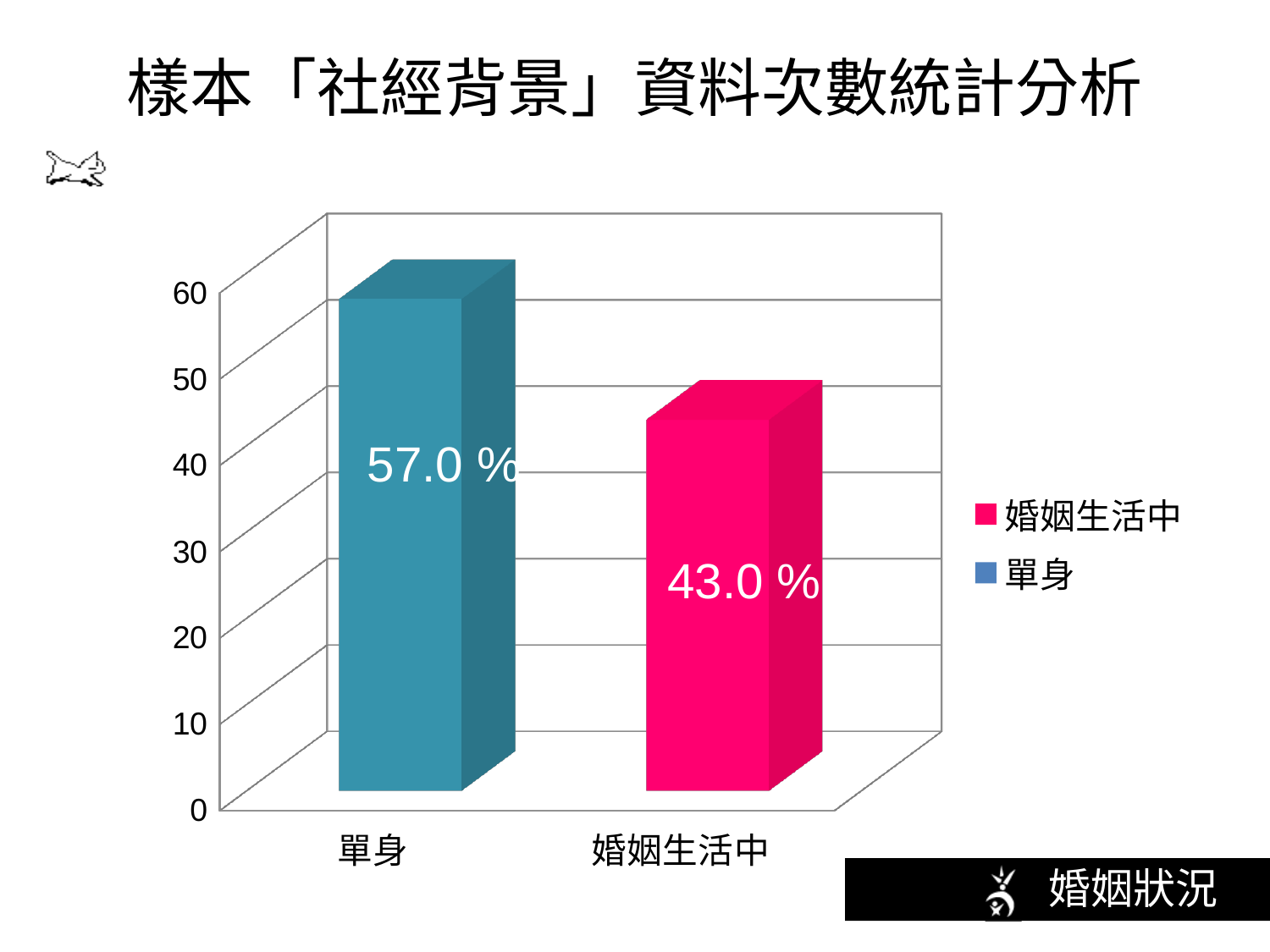
How many categories are shown on the x axis? 2 What kind of chart is shown on the slide? bar chart What is the value shown for 婚姻生活中? 43.0 % Which category has the lowest value? 婚姻生活中 Which is larger, the value for 單身 or the value for 婚姻生活中? 單身 Is the value for 婚姻生活中 greater or less than 50? less Is the value for 單身 greater or less than 50? greater What colour is the bar for 婚姻生活中? pink How many entries does the legend list? 2 What is the difference between the values for 單身 and 婚姻生活中? 14.0 % Which category has the highest value? 單身 What is the value shown for 單身? 57.0 %